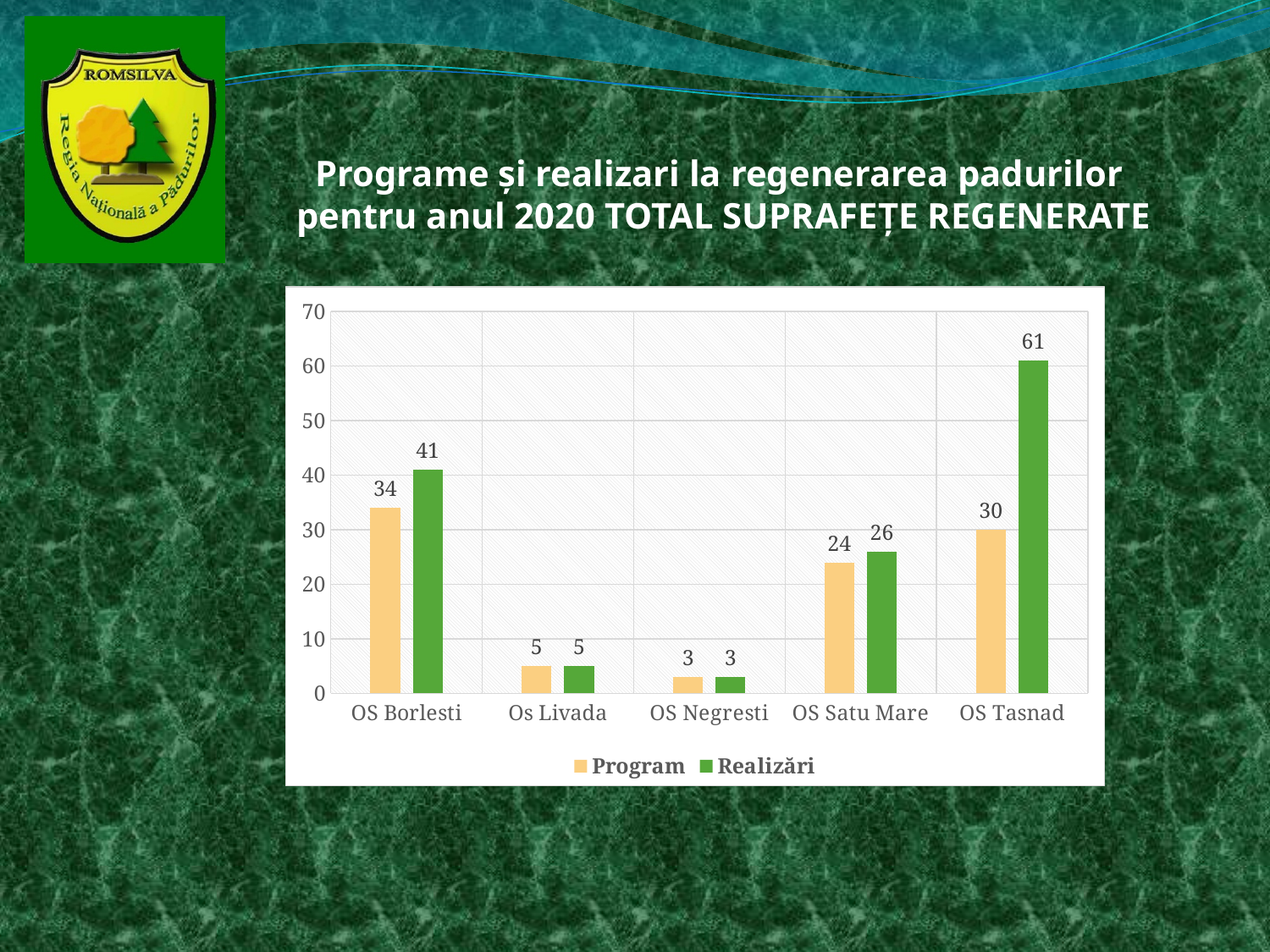
Which is larger for OS Satu Mare, the Program value or the Realizări value? Realizări Which category has the highest Realizări value? OS Tasnad Which colour represents the Program series in the chart? Light orange How many categories are shown on the x axis? 5 Which category has the lowest Program value? OS Negresti What is the Program value for OS Borlesti? 34 What is the Realizări value for OS Satu Mare? 26 What kind of chart is shown on the slide? bar chart What is the Realizări value for OS Tasnad? 61 How many series does the legend list? 2 What is the difference between the Realizări and Program values for OS Borlesti? 7 What is the difference between the Realizări and Program values for OS Tasnad? 31